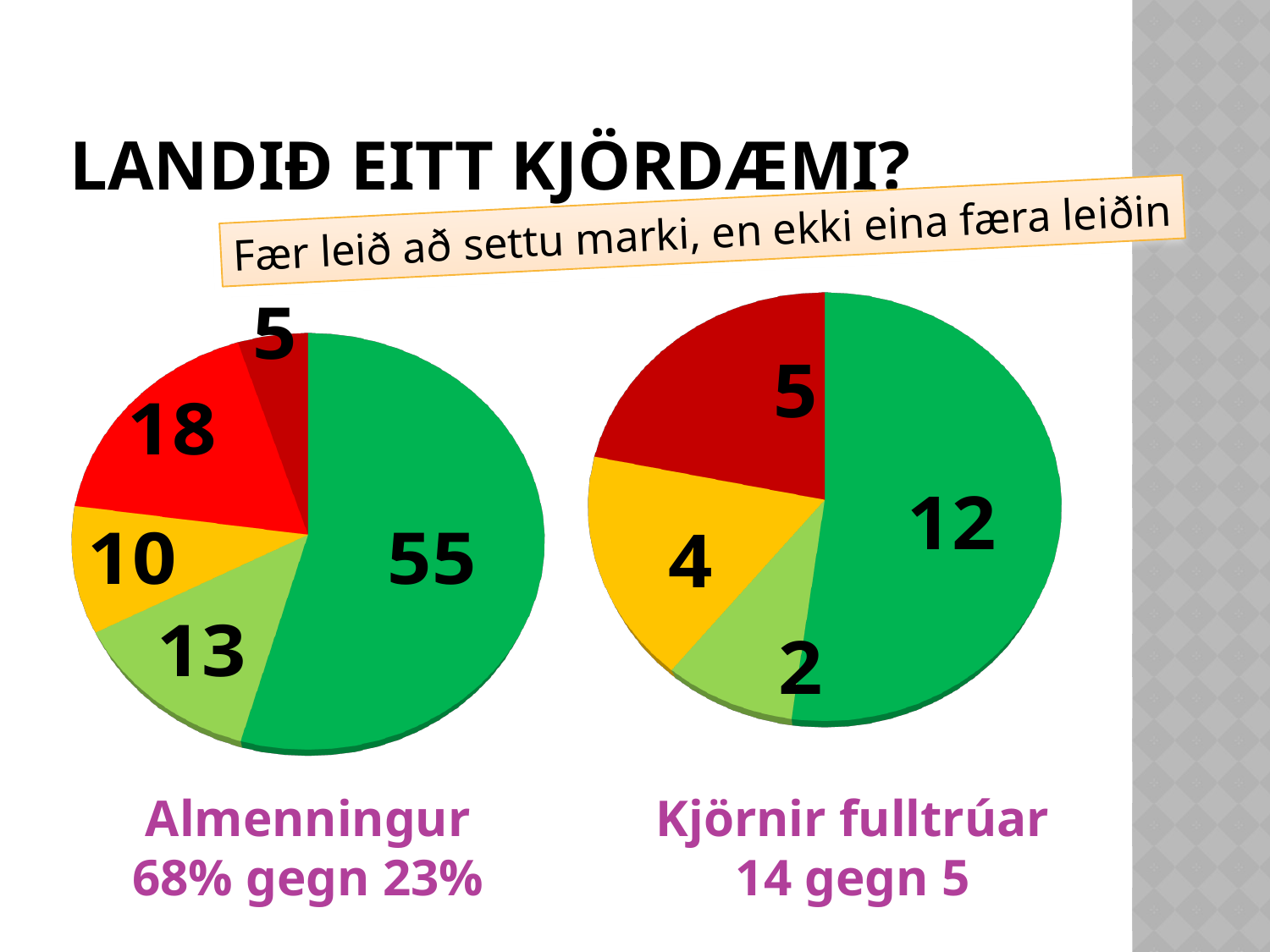
In the Kjörnir fulltrúar pie chart, what value is shown on the light green slice? 2 In the Kjörnir fulltrúar pie chart, which is larger: the yellow slice or the dark red slice? The dark red slice (5) How many slices does the Almenningur pie chart have? 5 In the Almenningur pie chart, what is the difference between the red slice (18) and the light green slice (13)? 5 In the Kjörnir fulltrúar pie chart, which slice has the smallest value? The light green slice (2) In the Almenningur pie chart, which slice has the largest value? The dark green slice (55) In the Almenningur pie chart, what value is shown on the yellow slice? 10 In the Almenningur pie chart, what value is shown on the dark green slice? 55 In the Kjörnir fulltrúar pie chart, what value is shown on the dark green slice? 12 How many slices does the Kjörnir fulltrúar pie chart have? 4 What kind of charts are shown on the slide? Pie charts In the Almenningur pie chart, which slice has the smallest value? The dark red slice (5)